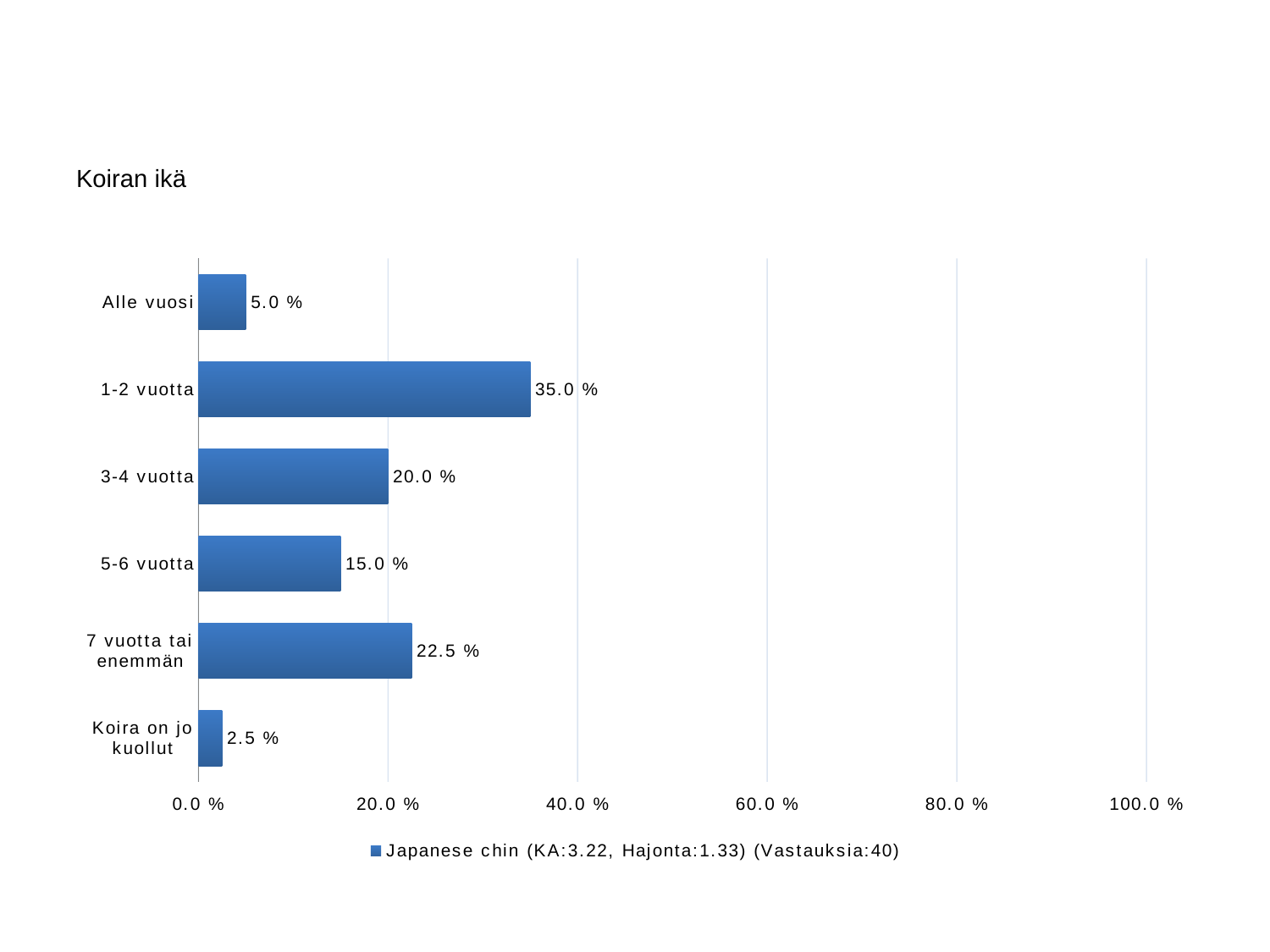
What is the title of the chart? Koiran ikä Which category has the lowest value? Koira on jo kuollut Which category has the highest value? 1-2 vuotta How many categories are shown on the chart? 6 How many series does the legend list? 1 What is the difference between the values for "1-2 vuotta" and "3-4 vuotta"? 15.0 % What kind of chart is shown on the slide? bar chart Is the value for "3-4 vuotta" greater or less than 40.0 %? less What is the value for "7 vuotta tai enemmän"? 22.5 % Which is larger, the value for "5-6 vuotta" or the value for "7 vuotta tai enemmän"? 7 vuotta tai enemmän What is the value for "1-2 vuotta"? 35.0 % What is the value for "Koira on jo kuollut"? 2.5 %